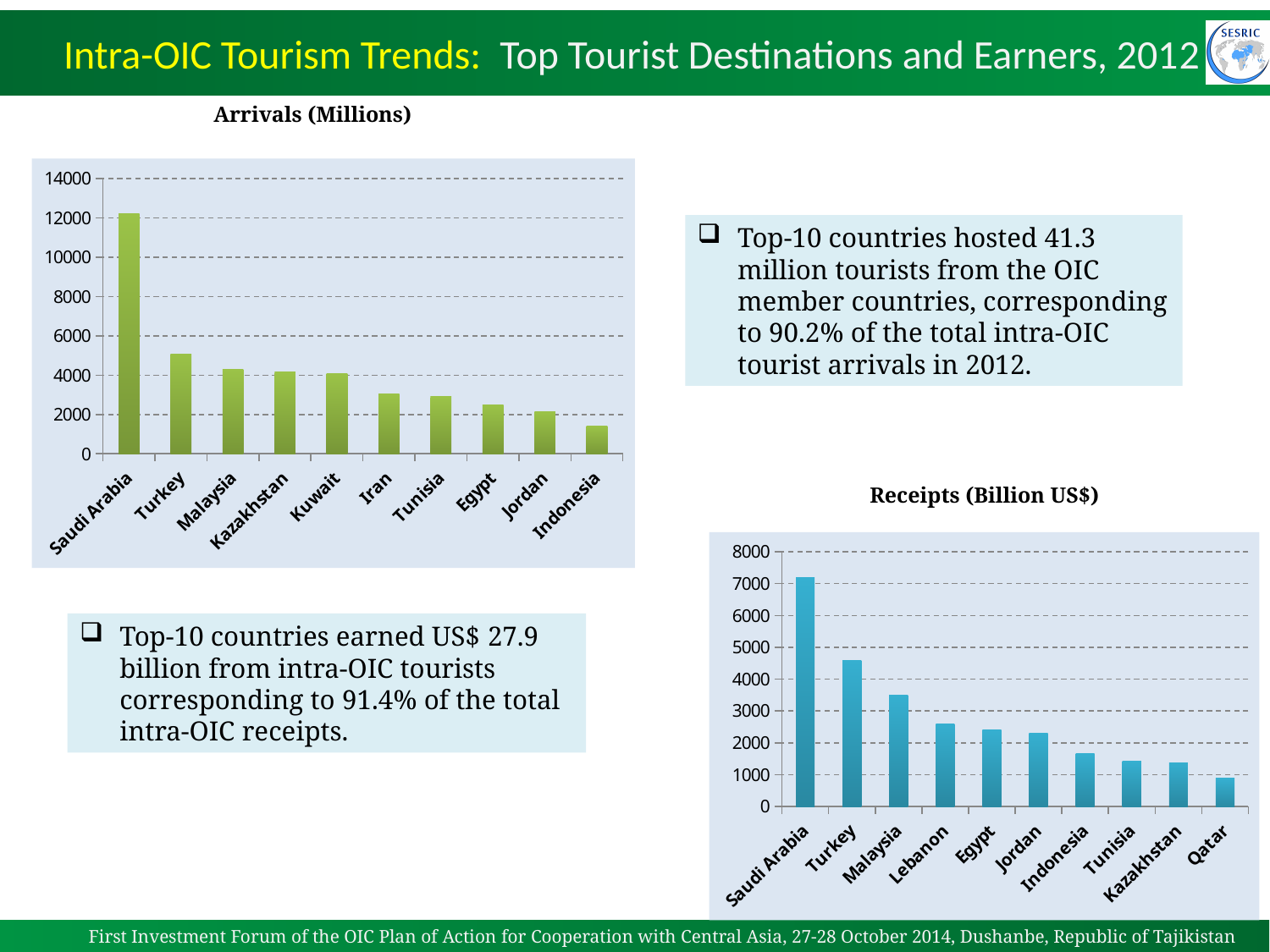
In the Arrivals (Millions) chart, is the value for Turkey greater or less than 6000? less In the Receipts (Billion US$) chart, which country has the lowest value? Qatar How many countries are shown in the Arrivals (Millions) chart? 10 What is the title of the chart in the lower right of the slide? Receipts (Billion US$) In the Arrivals (Millions) chart, which country has the lowest value? Indonesia In the Receipts (Billion US$) chart, is the value for Saudi Arabia greater or less than 7000? greater What kind of chart is the Arrivals (Millions) chart? Bar chart In the Arrivals (Millions) chart, which is larger, the value for Turkey or the value for Iran? Turkey In the Arrivals (Millions) chart, is the value for Saudi Arabia greater or less than 12000? greater In the Receipts (Billion US$) chart, do the values rise or fall from left to right along the x axis? Fall In the Receipts (Billion US$) chart, which country has the highest value? Saudi Arabia In the Arrivals (Millions) chart, which country has the highest value? Saudi Arabia